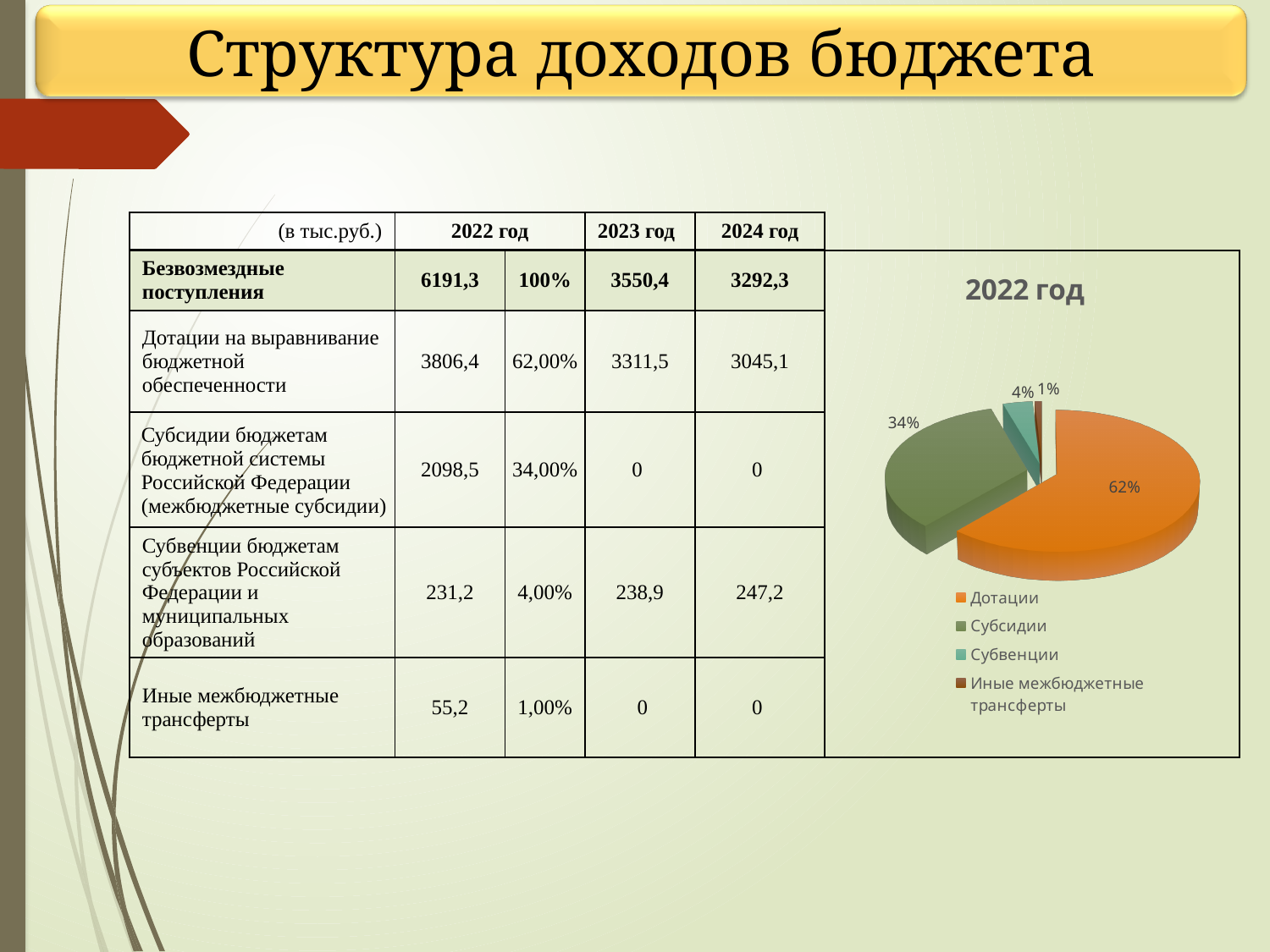
What share of the pie does Субсидии have? 34% What share of the pie does Иные межбюджетные трансферты have? 1% Which category has the smallest slice of the pie? Иные межбюджетные трансферты How many entries does the legend of the pie chart list? 4 What type of chart is shown on the slide? pie chart What share of the pie does Субвенции have? 4% What is the difference in percentage points between the Дотации slice and the Субсидии slice? 28 Which slice is larger, Субсидии or Субвенции? Субсидии How many slices does the pie chart have? 4 Which category has the largest slice of the pie? Дотации What is the title of the pie chart? 2022 год